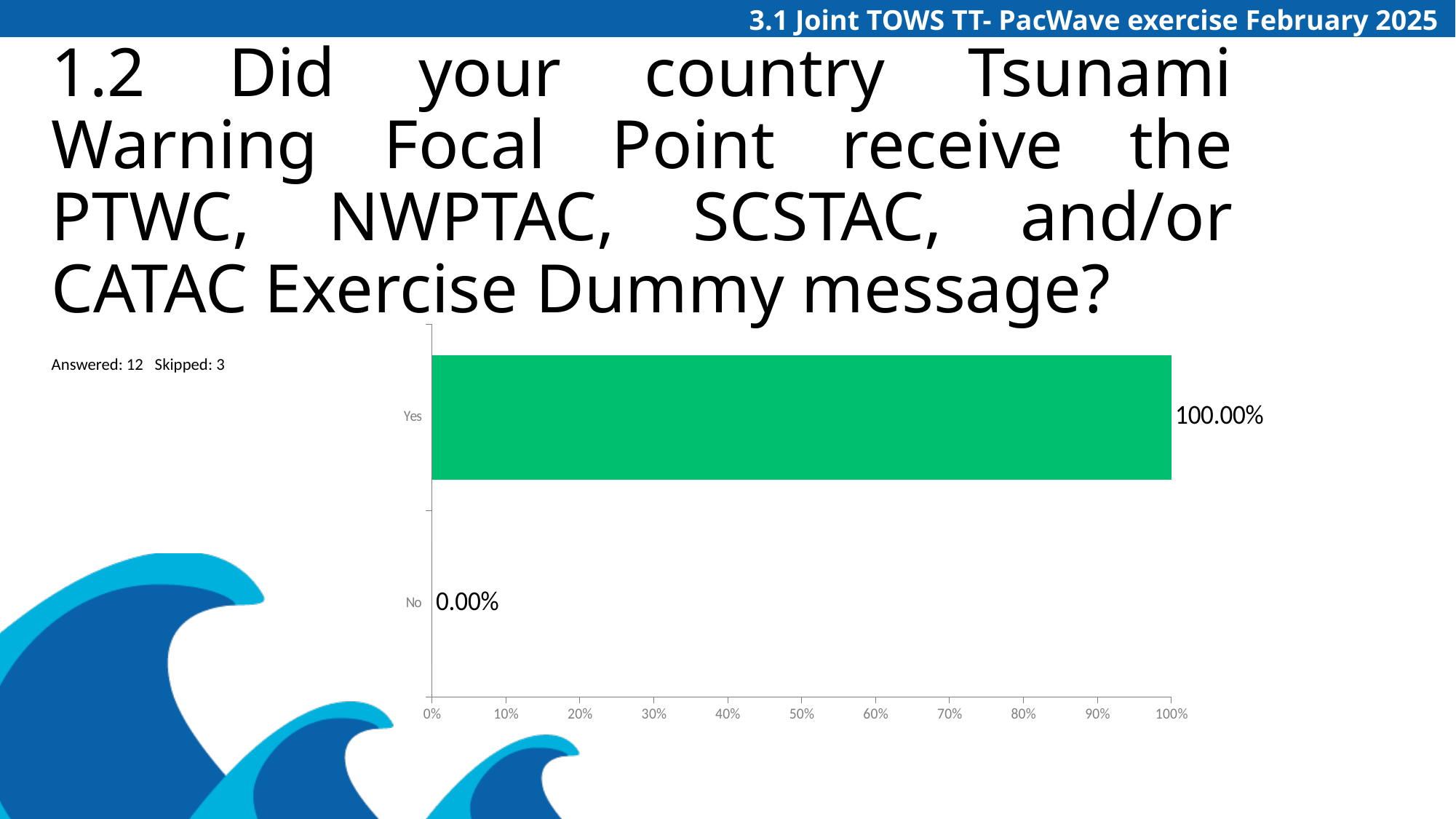
What is the value for No? 0.00% How many categories are shown on the chart? 2 What is the value for Yes? 100.00% What is the difference between the values for Yes and No? 100.00% Which category has the lowest value? No Which category has the highest value? Yes What is the maximum value shown on the x axis? 100% Which is larger, the value for Yes or the value for No? Yes How many respondents answered the question according to the slide? 12 What kind of chart is shown on the slide? bar chart Is the value for Yes greater or less than 50%? greater